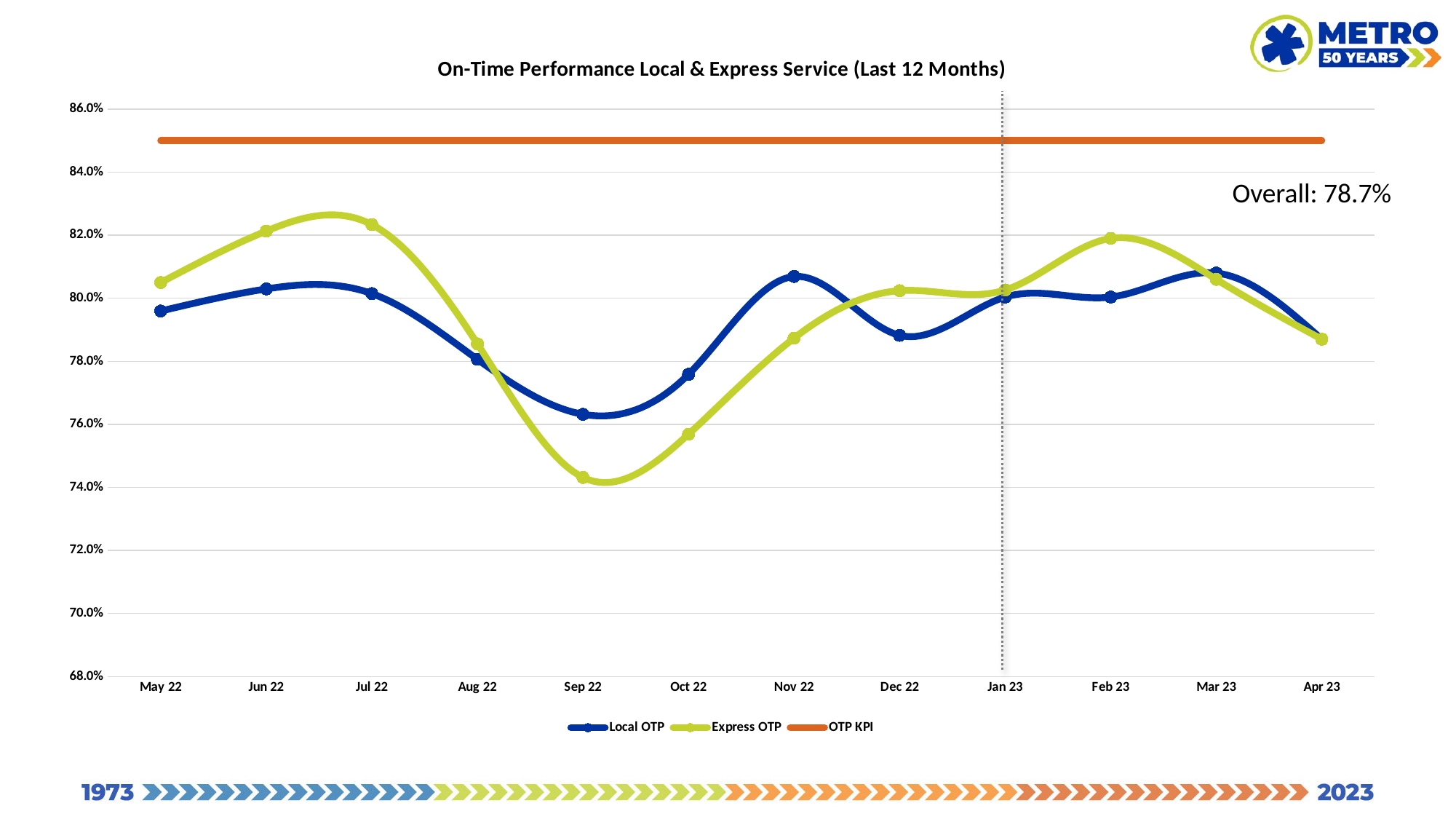
Does Express OTP rise or fall from Jul 22 to Sep 22? fall How many months are plotted along the x axis? 12 In Sep 22, which is larger: Local OTP or Express OTP? Local OTP How many series does the legend list? 3 Is the Express OTP value for Sep 22 greater or less than 76.0%? less What overall on-time performance value is printed on the slide? 78.7% Is the OTP KPI line greater or less than 84.0%? greater Is the Local OTP value for Nov 22 greater or less than 80.0%? greater In Jul 22, which is larger: Local OTP or Express OTP? Express OTP In which month is Express OTP at its lowest? Sep 22 What kind of chart is shown on the slide? line chart In which month is Local OTP at its lowest? Sep 22